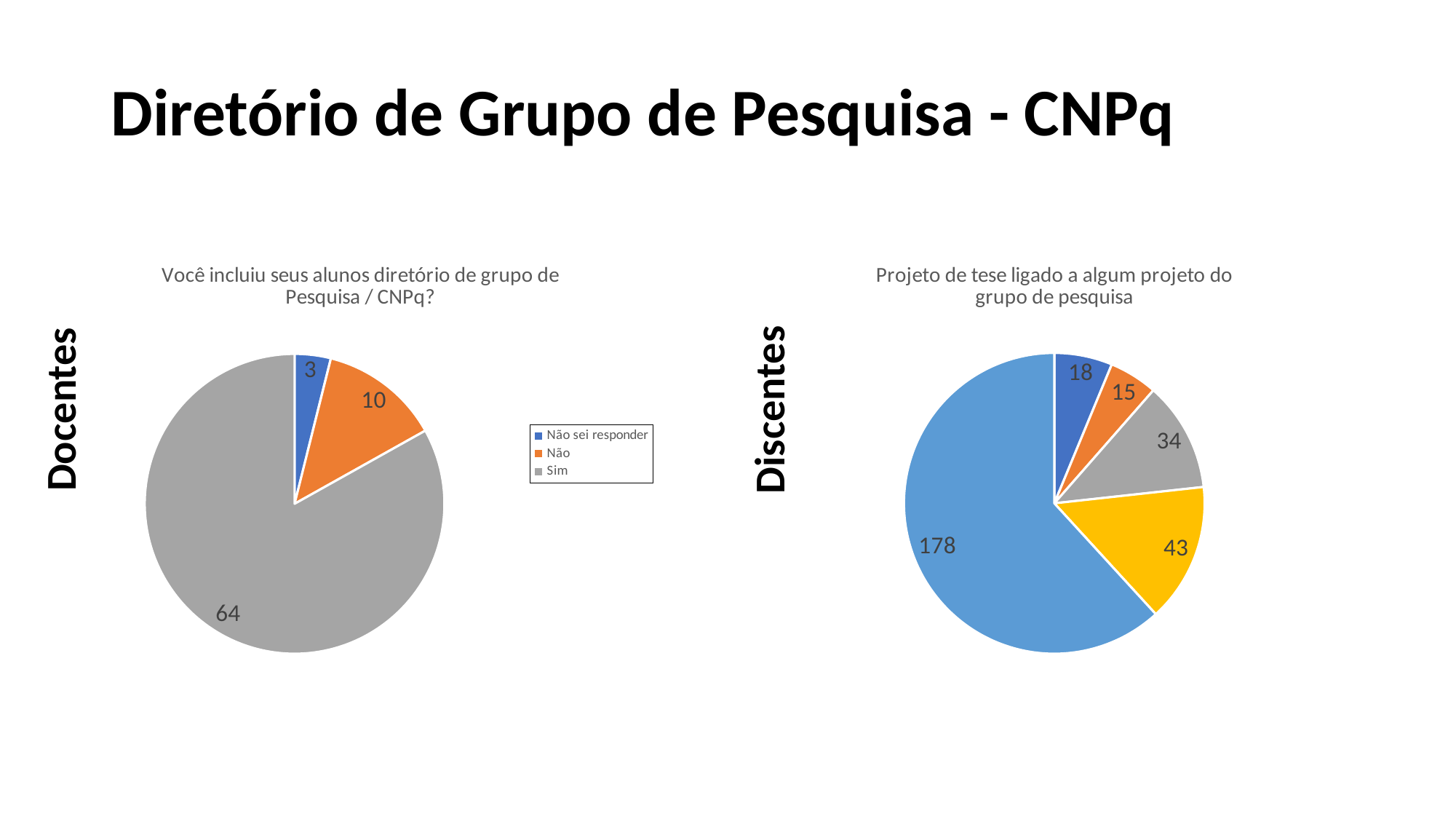
What type of chart is used for the Docentes chart on the left? pie chart In the Docentes chart on the left, what is the value for 'Não sei responder'? 3 In the Docentes chart on the left, which category has the largest slice? Sim In the Discentes chart on the right, what is the smallest value shown? 15 How many slices does the Discentes chart on the right have? 5 How many entries does the legend of the Docentes chart on the left list? 3 In the Docentes chart on the left, what is the value for 'Sim'? 64 What is the title of the Discentes chart on the right? Projeto de tese ligado a algum projeto do grupo de pesquisa In the Docentes chart on the left, what is the difference between the 'Sim' and 'Não' values? 54 In the Docentes chart on the left, what is the value for 'Não'? 10 In the Docentes chart on the left, which category has the smallest slice? Não sei responder In the Discentes chart on the right, what is the largest value shown? 178